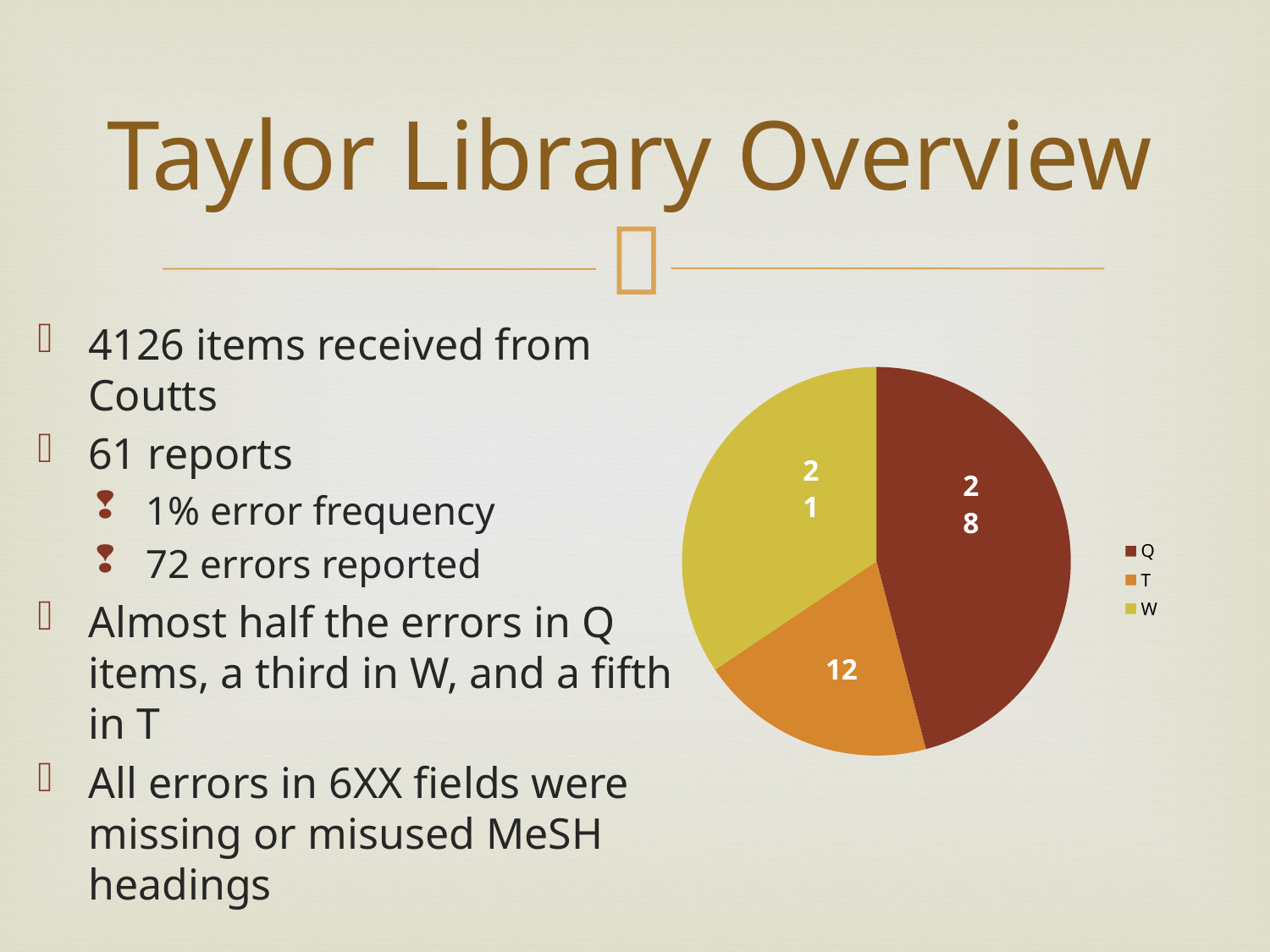
What is the total of all the slices in the pie chart? 61 Which category has the largest slice in the pie chart? Q What is the difference between the values for Q and W? 7 What kind of chart is shown on the slide? pie chart Which is larger, the value for W or the value for T? W What is the value for Q in the pie chart? 28 Which category has the smallest slice in the pie chart? T Which legend entry is shown in orange? T What is the difference between the values for Q and T? 16 How many slices does the pie chart have? 3 What is the value for T in the pie chart? 12 What is the value for W in the pie chart? 21